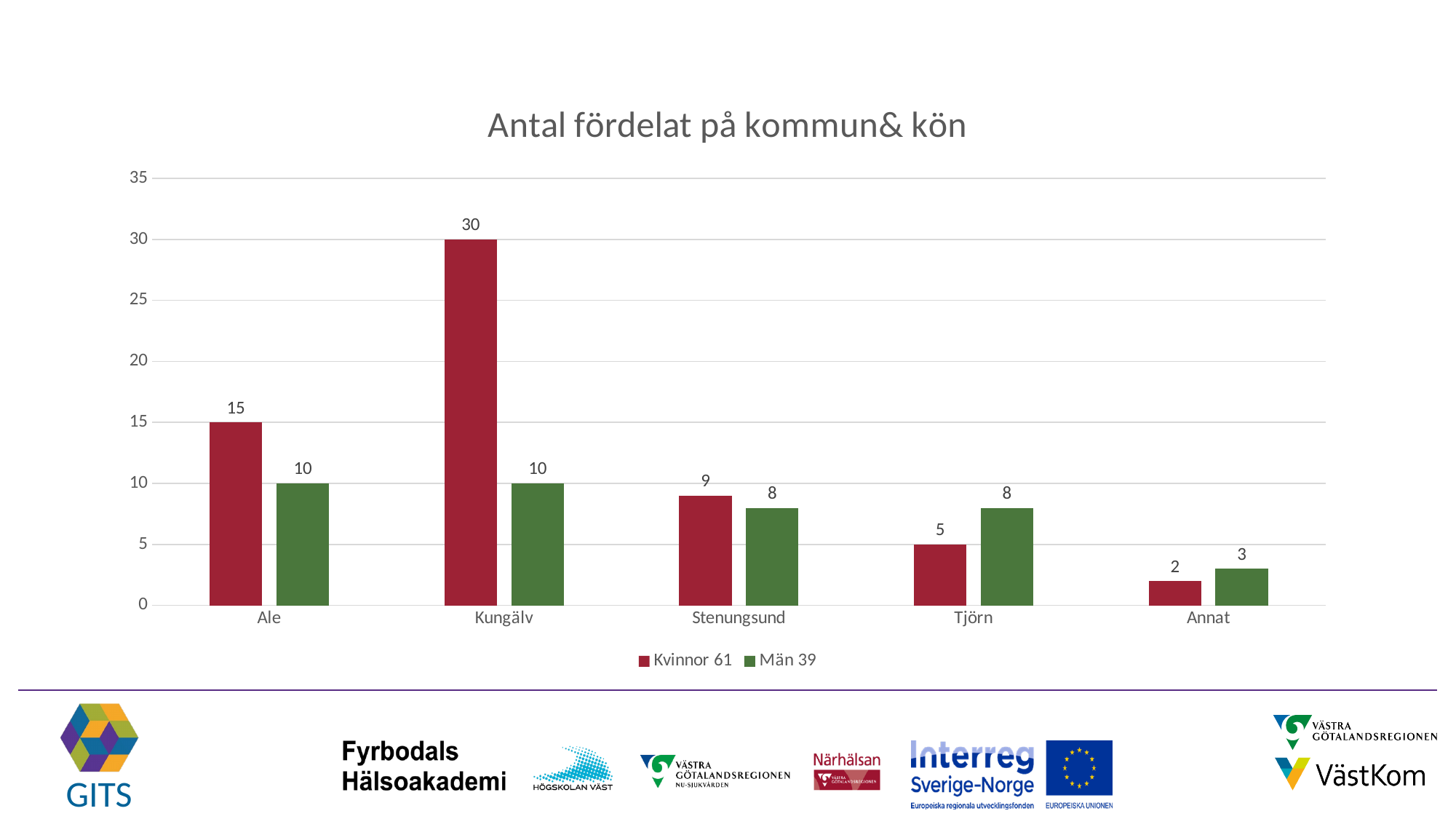
What is the value for Kvinnor 61 in Tjörn? 5 How many categories are shown on the x axis? 5 How many series does the legend list? 2 Which category has the highest value for Kvinnor 61? Kungälv What kind of chart is shown on the slide? bar chart What is the difference between Kvinnor 61 and Män 39 in Kungälv? 20 Is the value for Kvinnor 61 in Ale greater or less than 10? greater What is the title of the chart? Antal fördelat på kommun& kön Which is larger in Tjörn, Kvinnor 61 or Män 39? Män 39 What is the value for Män 39 in Stenungsund? 8 Which category has the lowest value for Män 39? Annat What is the value for Kvinnor 61 in Kungälv? 30